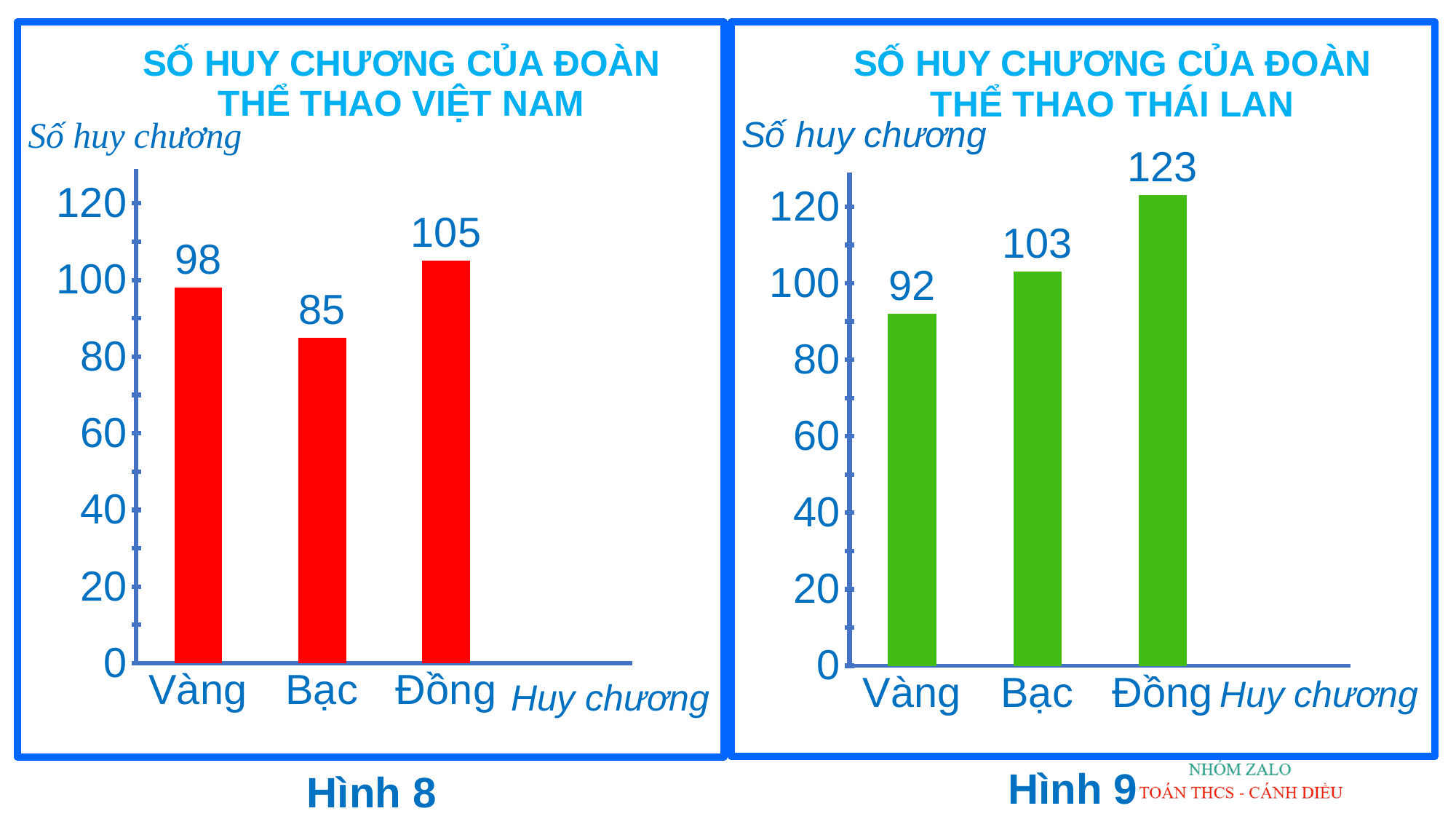
In the Thailand chart (Hình 9, right), which is larger, the Bạc count or the Vàng count? Bạc What type of chart is the Thailand chart (Hình 9, right)? Bar chart In the Vietnam chart (Hình 8, left), how many medals are shown for Bạc? 85 What colour are the bars in the Vietnam chart (Hình 8, left)? Red In the Vietnam chart (Hình 8, left), which medal type has the highest count? Đồng In the Vietnam chart (Hình 8, left), how many medals are shown for Vàng? 98 In the Thailand chart (Hình 9, right), what is the difference between the Đồng and Vàng counts? 31 In the Vietnam chart (Hình 8, left), what is the difference between the Đồng and Bạc counts? 20 In the Thailand chart (Hình 9, right), how many medals are shown for Vàng? 92 In the Thailand chart (Hình 9, right), how many medals are shown for Đồng? 123 How many categories are shown on the x axis of the Vietnam chart (Hình 8, left)? 3 In the Thailand chart (Hình 9, right), which medal type has the lowest count? Vàng